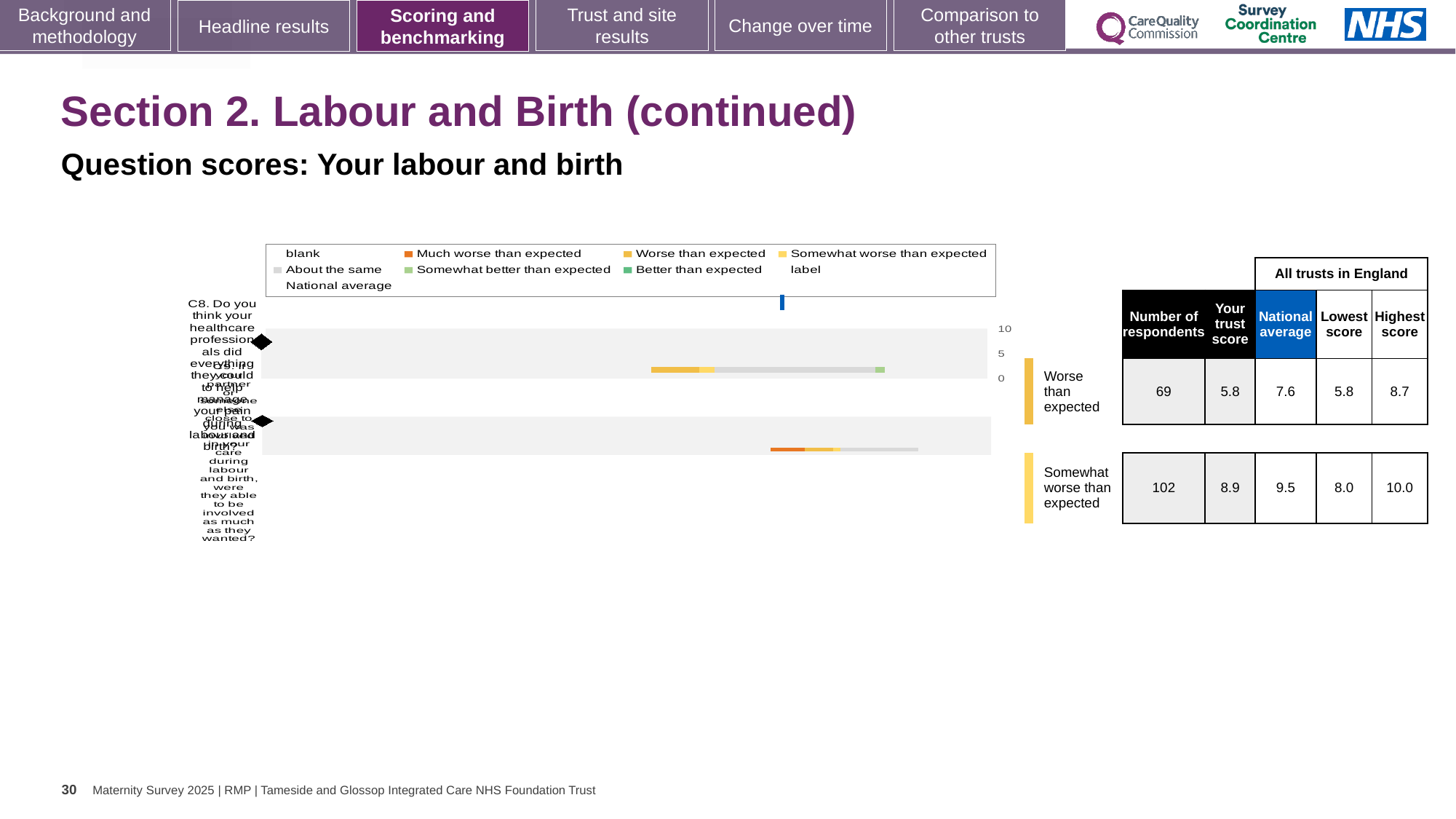
What is the national average for question C8? 7.6 What is the difference between the highest score and the lowest score for question C8? 2.9 What is the highest score across all trusts in England for the second question row (Somewhat worse than expected)? 10.0 How many respondents are listed for the second question row (Somewhat worse than expected)? 102 What colour does the legend use for 'Much worse than expected'? orange How many entries does the chart legend list? 9 Which row has the larger 'Your trust score': C8 or the second question row (Somewhat worse than expected)? the second question row (Somewhat worse than expected) What is the 'Your trust score' value for question C8? 5.8 Which benchmark category is shown beside the C8 row? Worse than expected How many survey questions are plotted as rows in the chart? 2 What kind of chart is shown on the slide? bar chart By how much does the national average exceed the trust score for question C8? 1.8